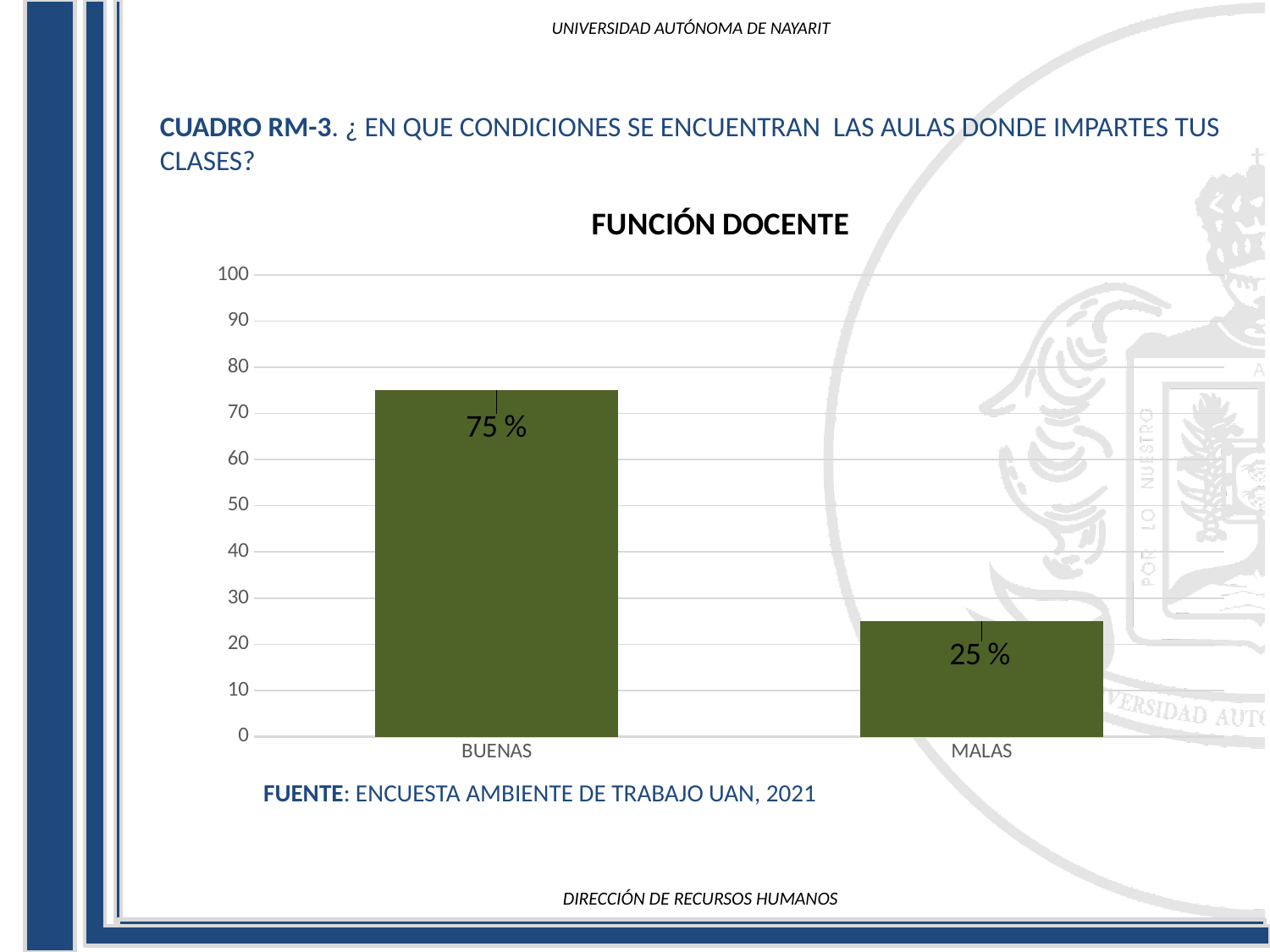
What is the value for BUENAS? 75 % How many categories are shown on the x axis? 2 Which category has the lowest value? MALAS Which is larger, the value for BUENAS or the value for MALAS? BUENAS Is the value for MALAS greater or less than 30? less What kind of chart is shown? bar chart Is the value for BUENAS greater or less than 70? greater What is the difference between the values for BUENAS and MALAS? 50 % What is the value for MALAS? 25 % Which category has the highest value? BUENAS What is the highest value shown on the y axis? 100 What is the title of the chart? FUNCIÓN DOCENTE